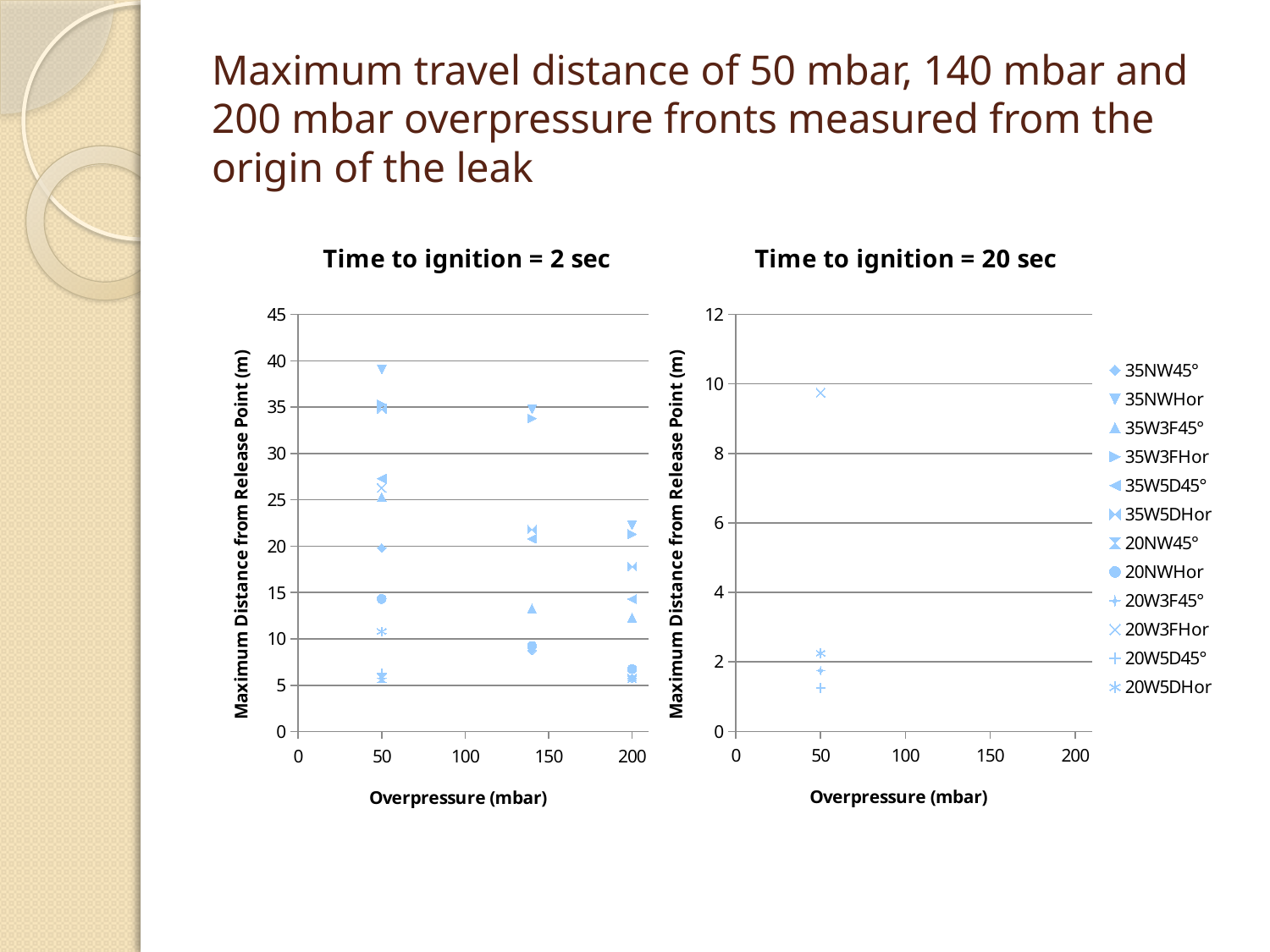
In the "Time to ignition = 2 sec" chart, is the value for 20NWHor at 50 mbar greater or less than 10? greater In the "Time to ignition = 2 sec" chart, do the values for 35NWHor rise or fall as overpressure increases from 50 to 200 mbar? fall In the "Time to ignition = 20 sec" chart, is the value for 20W3FHor at 50 mbar greater or less than 8? greater In the "Time to ignition = 2 sec" chart, is the value for 35NWHor at 50 mbar greater or less than 35? greater In the "Time to ignition = 2 sec" chart, which series has the highest plotted point? 35NWHor In the "Time to ignition = 2 sec" chart, at how many distinct overpressure values are points plotted? 3 In the "Time to ignition = 20 sec" chart, which series has the highest plotted point? 20W3FHor What kind of chart is the "Time to ignition = 2 sec" chart? scatter chart How many series does the legend list for the charts on the slide? 12 In the "Time to ignition = 2 sec" chart, at 50 mbar, which is larger: the value for 35NWHor or the value for 20NWHor? 35NWHor What is the label of the y axis on the "Time to ignition = 20 sec" chart? Maximum Distance from Release Point (m)